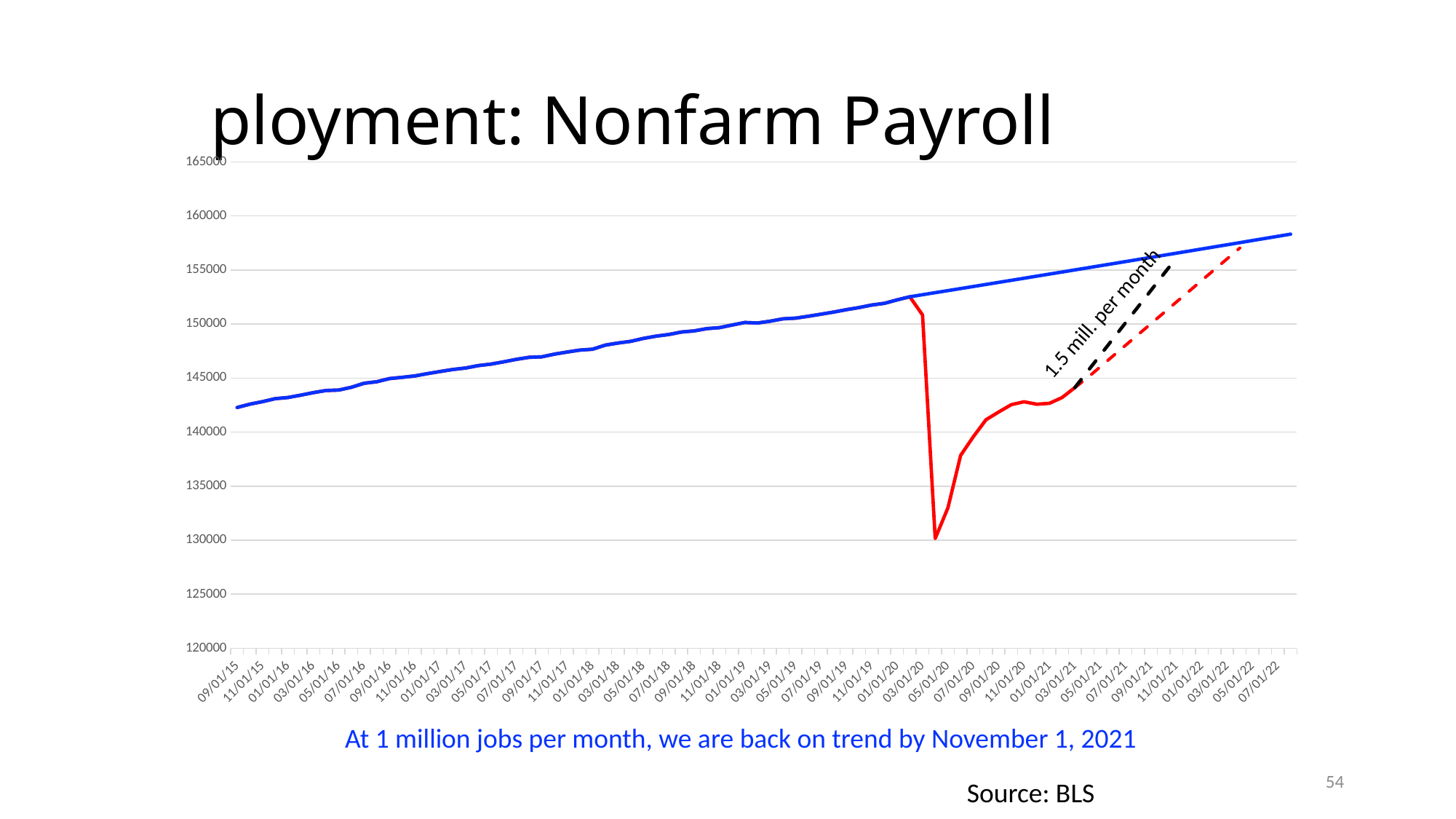
Is the value of the blue line at 01/01/18 greater or less than 150000? less Is the value of the blue line at 07/01/22 greater or less than 155000? greater Which line reaches the lowest value on the chart, the blue line or the red line? the red line Is the lowest value of the red line greater or less than 125000? greater Does the blue line rise or fall from 09/01/15 to 07/01/22? rise What source is cited below the chart? BLS At 05/01/20, which line has the higher value, the blue line or the red line? the blue line What rate is written next to the black dashed line on the chart? 1.5 mill. per month What kind of chart is shown on the slide? line chart